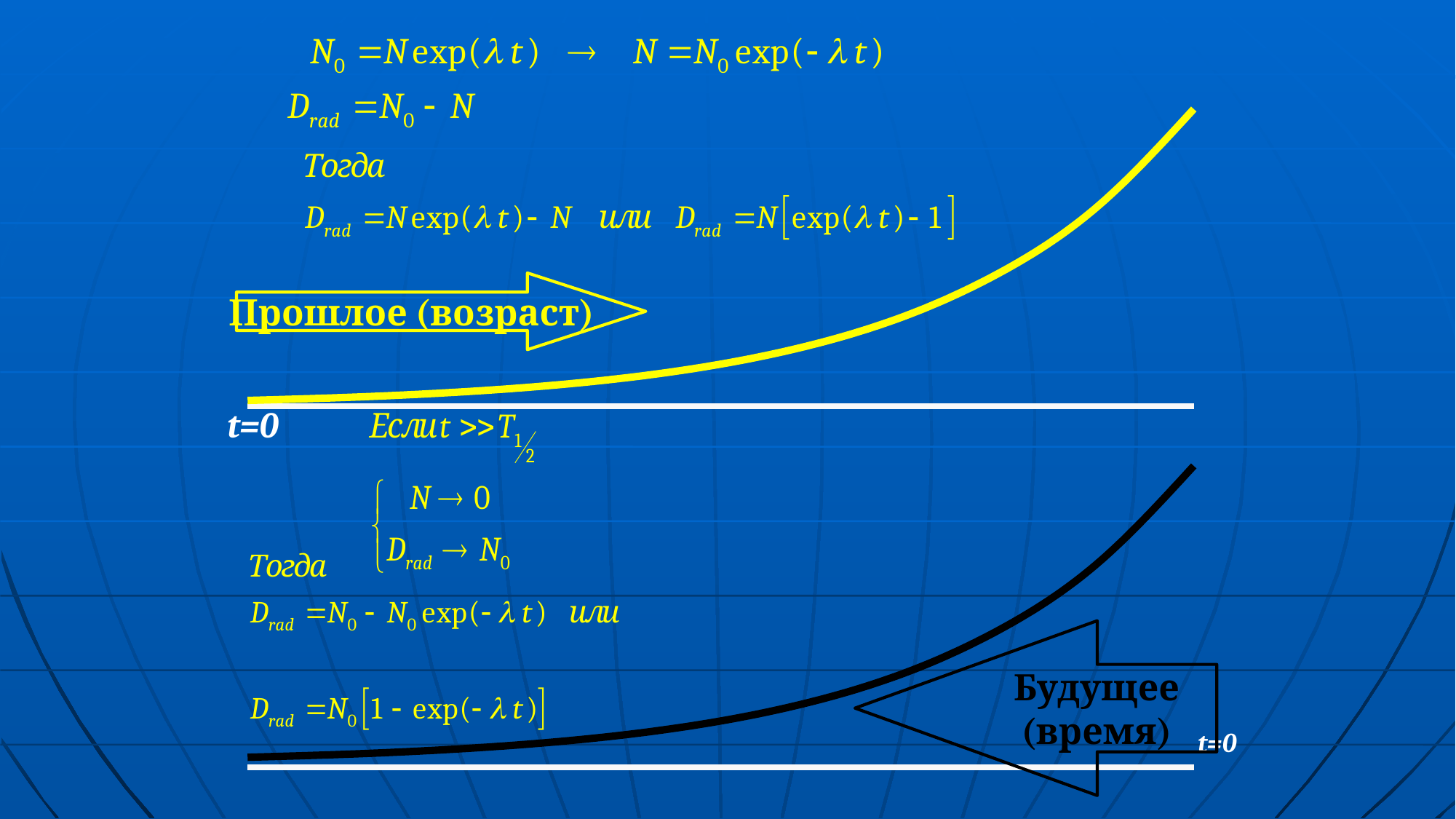
What colour is the curve in the upper diagram? yellow In the lower diagram, does the black curve rise or fall from left to right along the time axis? rise What label is written at the left end of the upper diagram's horizontal axis? t=0 How many curves are drawn on the slide in total? 2 In the upper diagram, does the yellow curve rise or fall from left to right along the time axis? rise